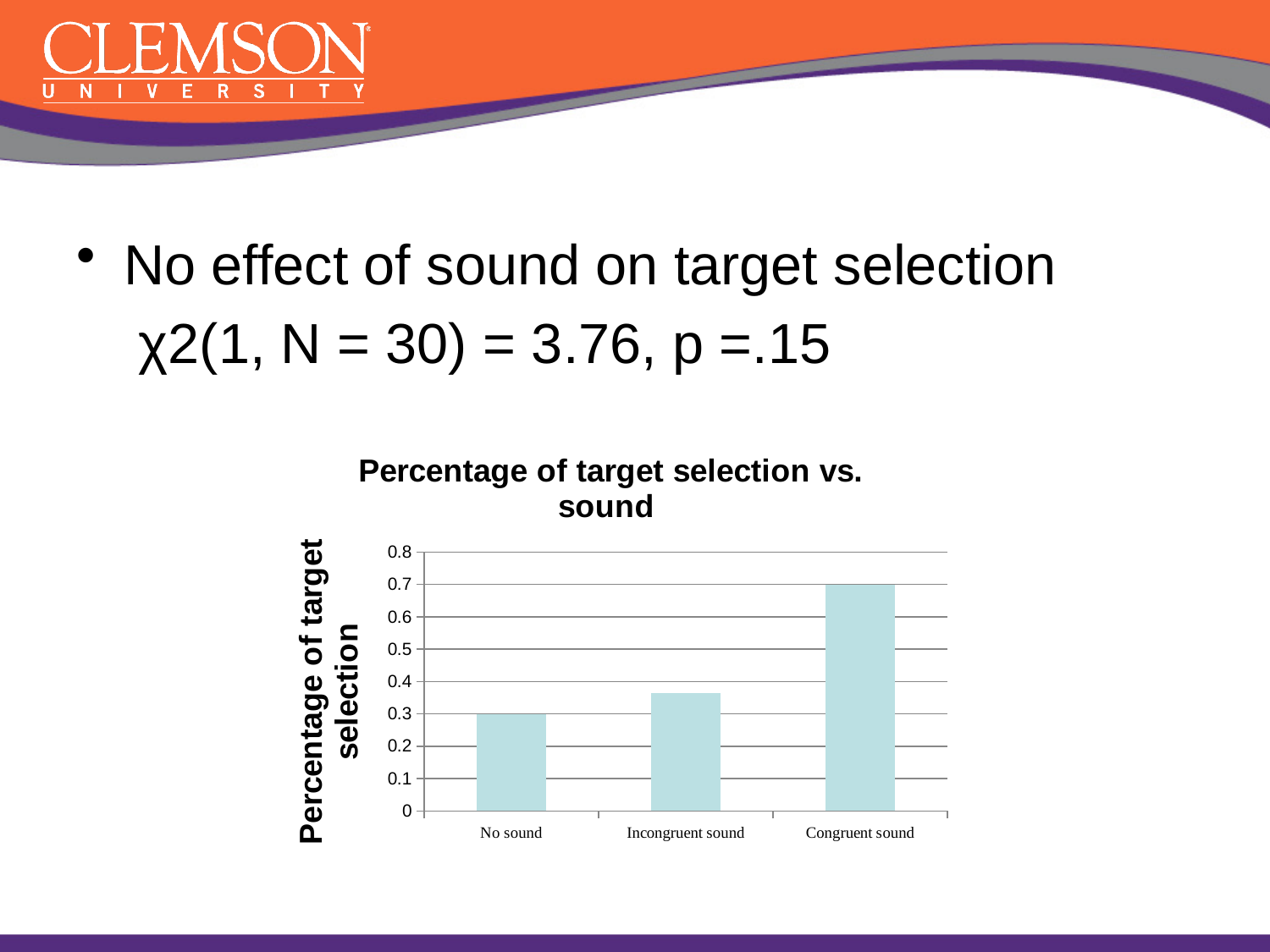
What is the percentage of target selection for Congruent sound? 0.7 What kind of chart is shown on the slide? bar chart What is the difference between the values for Congruent sound and No sound? 0.4 Which category has the highest percentage of target selection? Congruent sound What is the title of the chart? Percentage of target selection vs. sound Do the values rise or fall from left to right along the x axis? rise Is the value for Incongruent sound greater or less than 0.3? greater Which is larger, the value for Congruent sound or the value for Incongruent sound? Congruent sound Which category has the lowest percentage of target selection? No sound What is the percentage of target selection for No sound? 0.3 How many categories are shown on the x axis of the chart? 3 Is the value for Incongruent sound greater or less than 0.4? less